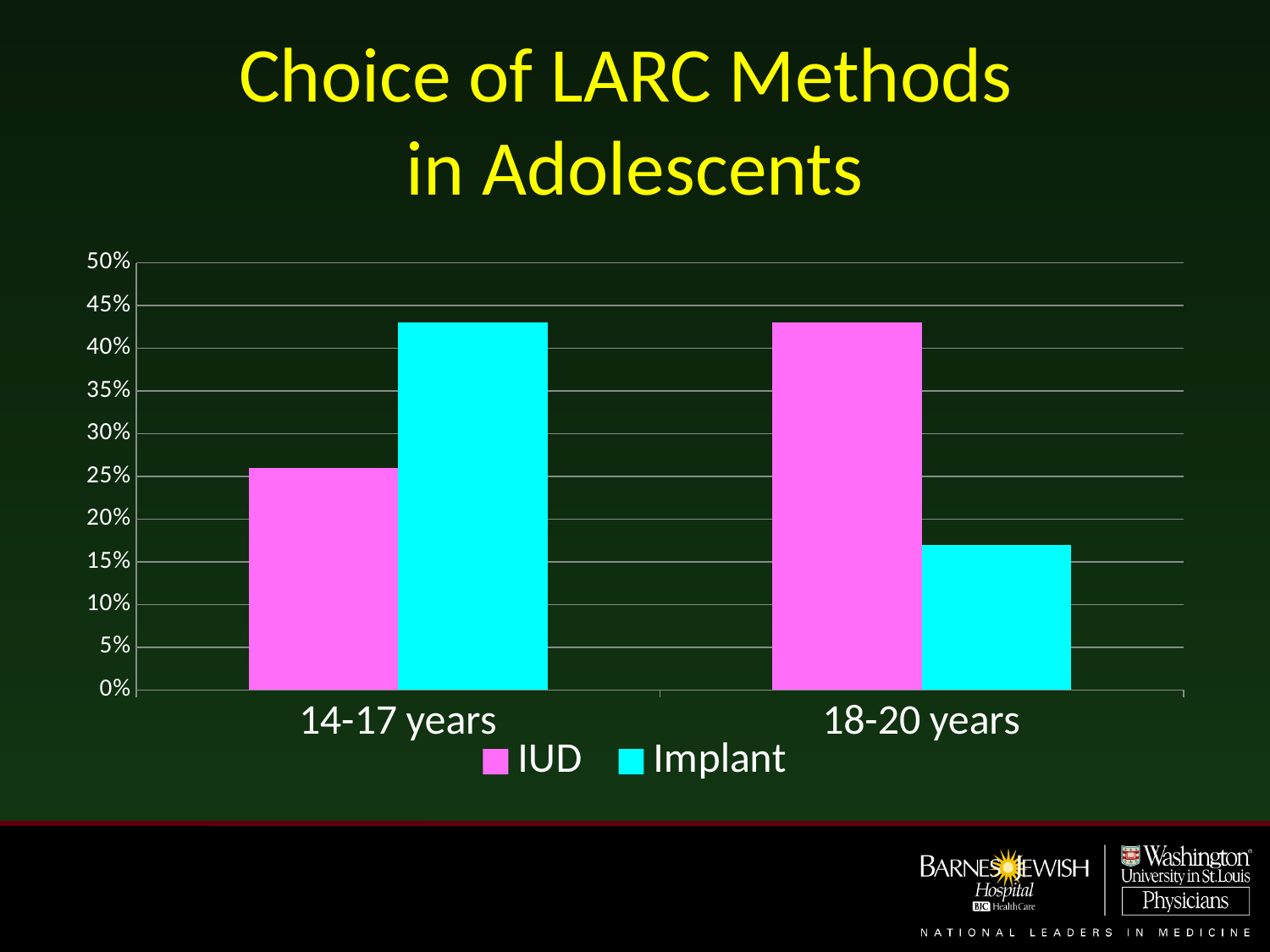
For 14-17 years, which is larger, IUD or Implant? Implant Is the IUD value for 18-20 years greater or less than 40%? greater Is the Implant value for 14-17 years greater or less than 40%? greater Is the IUD value for 14-17 years greater or less than 30%? less Which age group has the higher Implant value? 14-17 years Which age group has the lower IUD value? 14-17 years For 18-20 years, which is larger, IUD or Implant? IUD How many age-group categories are shown on the x axis? 2 How many series does the legend list? 2 What colour are the Implant bars? cyan What kind of chart is shown on the slide? bar chart